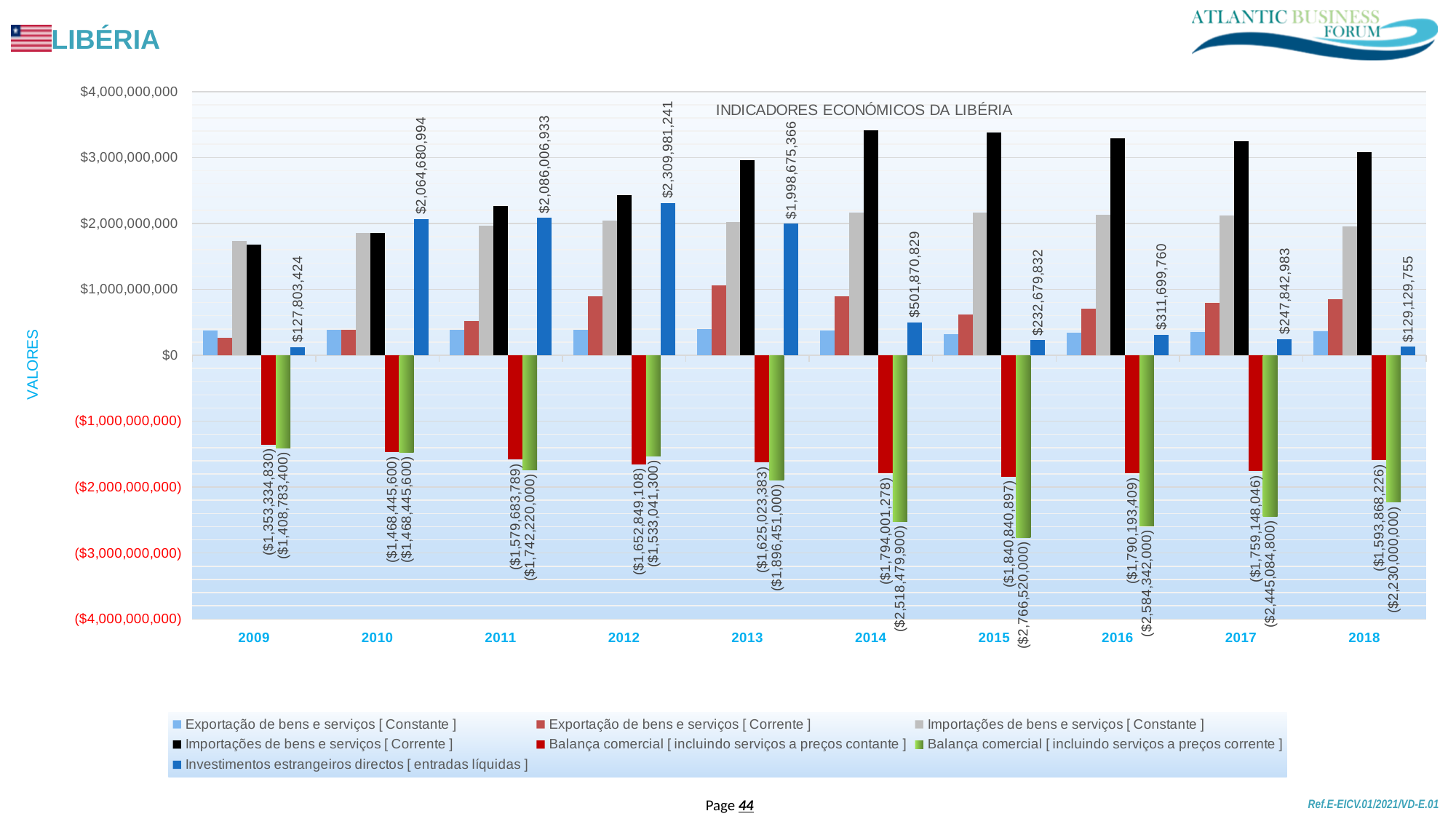
What is the value of Balança comercial [incluindo serviços a preços corrente] in 2015? ($2,766,520,000) What is the value of Balança comercial [incluindo serviços a preços contante] in 2009? ($1,353,334,830) Is the value for Importações de bens e serviços [Corrente] in 2014 greater or less than $3,000,000,000? greater In which year is Investimentos estrangeiros directos [entradas líquidas] highest? 2012 What is the difference between Investimentos estrangeiros directos in 2011 and in 2010? $21,325,939 How many years are shown on the x axis? 10 In which year is Investimentos estrangeiros directos [entradas líquidas] lowest? 2009 Which year has the larger value for Investimentos estrangeiros directos, 2014 or 2015? 2014 What is the title of the chart? INDICADORES ECONÓMICOS DA LIBÉRIA What kind of chart is shown on the slide? Bar chart What is the value of Investimentos estrangeiros directos [entradas líquidas] in 2012? $2,309,981,241 How many series does the legend list? 7